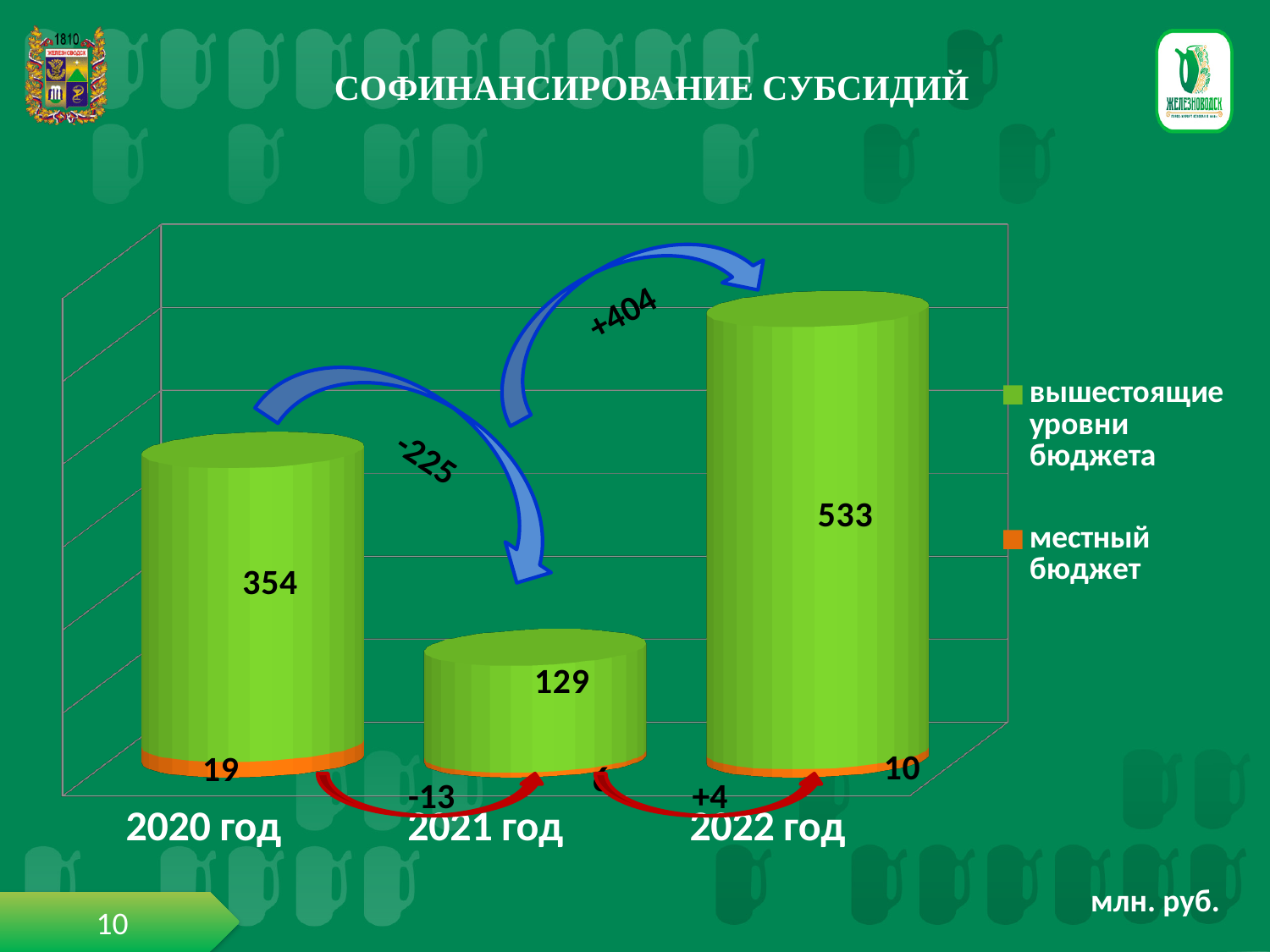
What is the value for местный бюджет in 2022 год? 10 Which year has the highest value for вышестоящие уровни бюджета? 2022 год How many series does the legend list? 2 What is the value for вышестоящие уровни бюджета in 2021 год? 129 What is the value for вышестоящие уровни бюджета in 2020 год? 354 What is the value for местный бюджет in 2020 год? 19 Which is larger, the вышестоящие уровни бюджета value for 2020 год or for 2021 год? 2020 год What is the difference between the вышестоящие уровни бюджета values for 2022 год and 2020 год? 179 What is the total of the stacked bar for 2020 год? 373 How many years are shown on the chart? 3 What is the value for вышестоящие уровни бюджета in 2022 год? 533 Which year has the lowest value for вышестоящие уровни бюджета? 2021 год